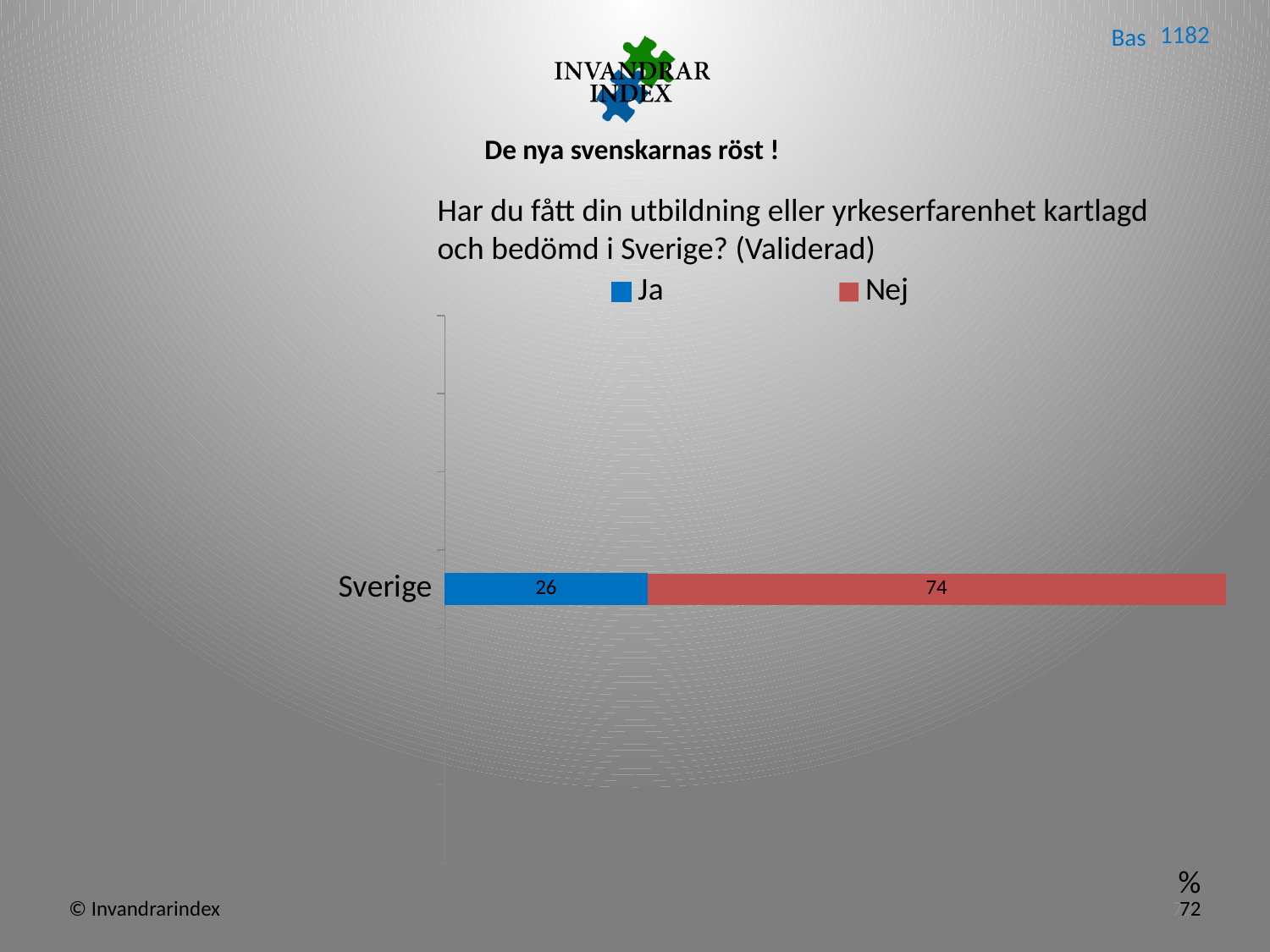
What is the value for Nej for Sverige? 74 What is the difference between the Nej and Ja values for Sverige? 48 What is the total of the stacked bar for Sverige? 100 Which category is shown on the chart's axis? Sverige How many categories are plotted on the chart? 1 How many series does the legend list? 2 Which series has the larger value for Sverige, Ja or Nej? Nej What colour represents the Nej series? Red What is the value for Ja for Sverige? 26 What kind of chart is shown on the slide? Stacked bar chart